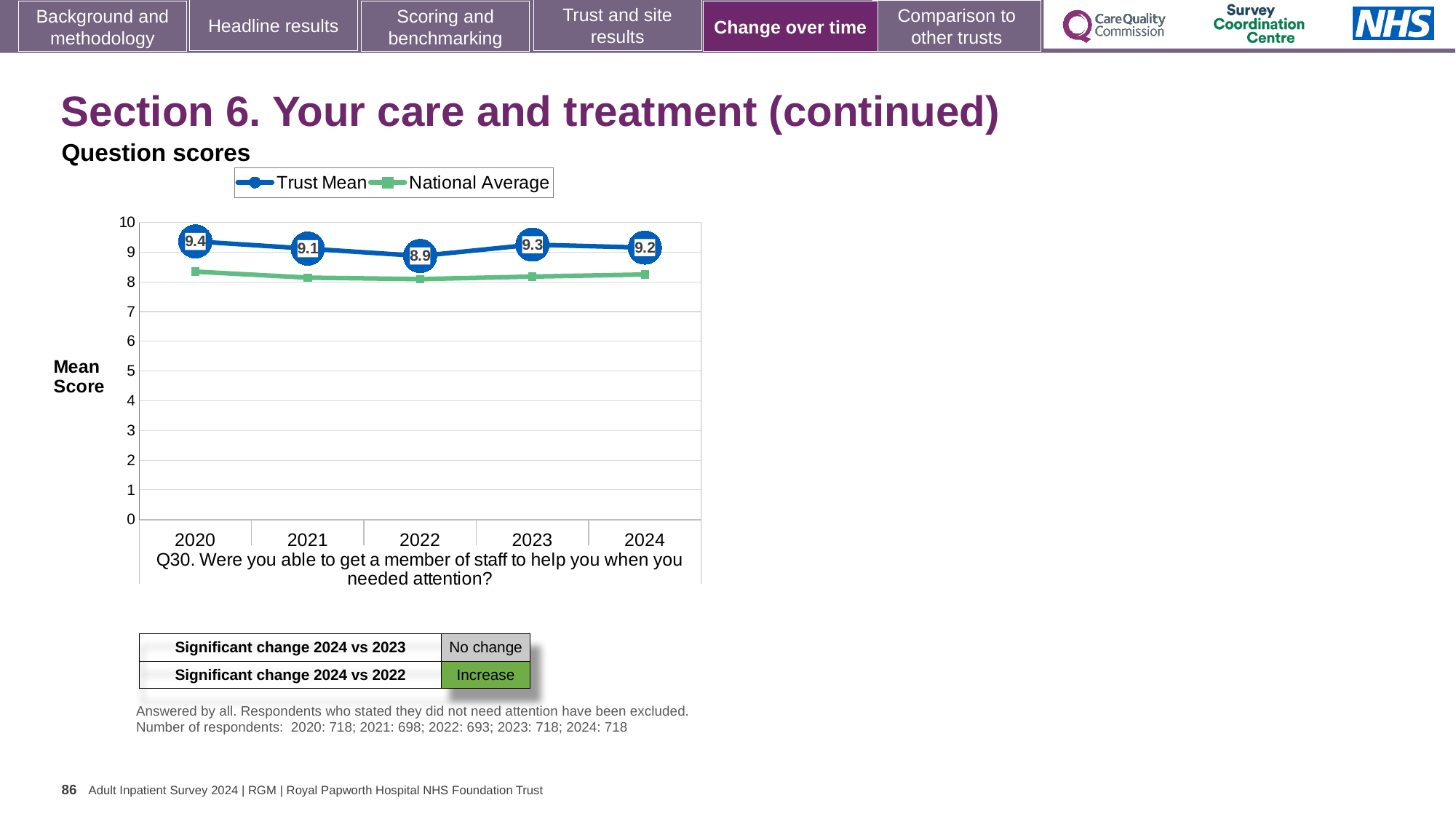
What is the Trust Mean score for 2022? 8.9 What is the Trust Mean score for 2024? 9.2 What kind of chart is shown on the slide? line chart How many years are shown on the x axis of the chart? 5 How many series does the chart legend list? 2 In which year is the Trust Mean score highest? 2020 Which is larger, the Trust Mean score for 2023 or for 2021? 2023 Is the National Average value for 2022 greater or less than 9? less What is the Trust Mean score for 2020? 9.4 Which question does the chart relate to? Q30. Were you able to get a member of staff to help you when you needed attention? In which year is the Trust Mean score lowest? 2022 What is the difference between the Trust Mean scores for 2020 and 2022? 0.5